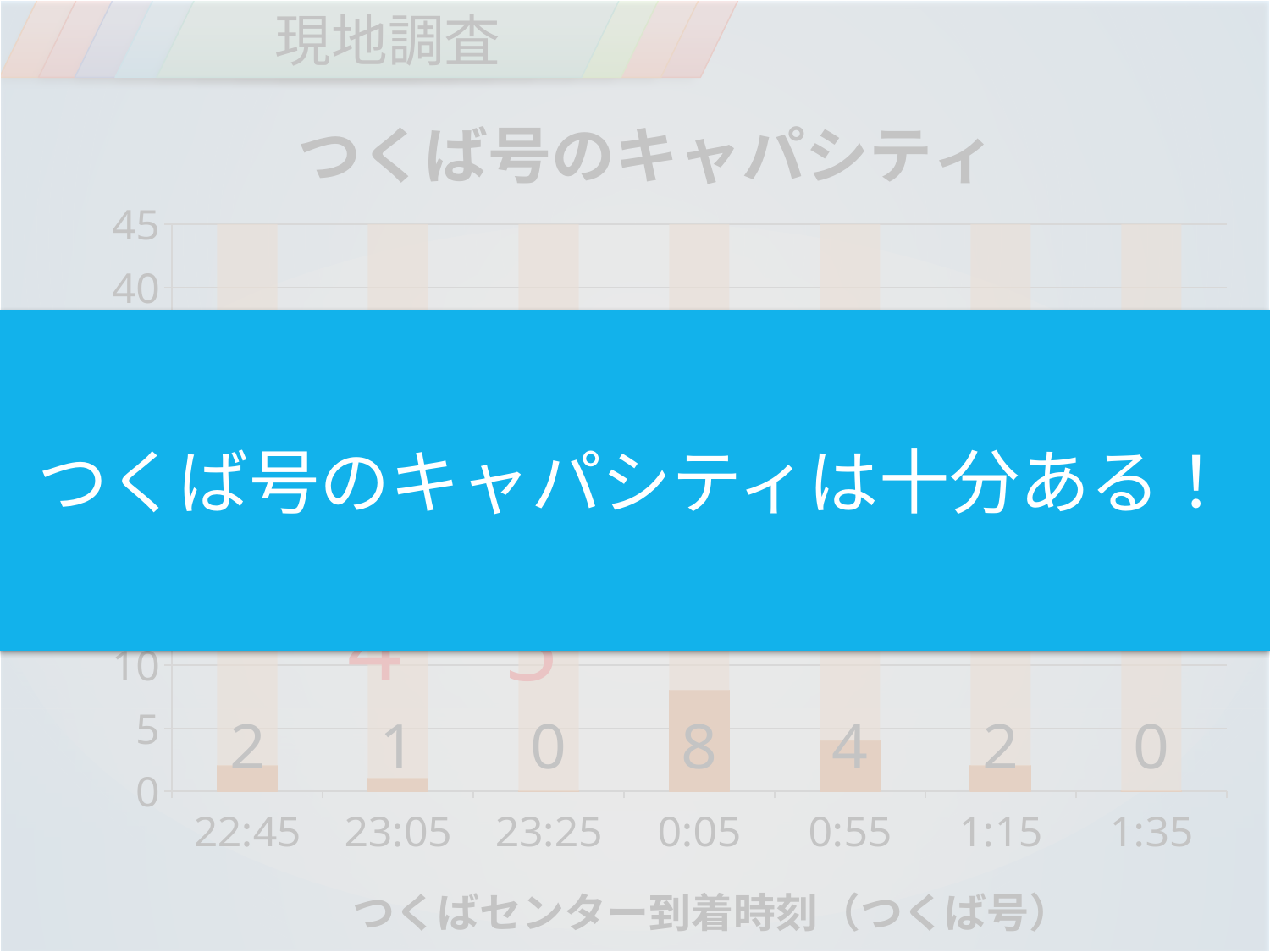
What is the title of the chart? つくば号のキャパシティ What is the value shown for 0:05 in the lower data labels? 8 How many arrival time categories are shown on the x axis? 7 Is the lower data label value for 0:05 greater or less than 5? greater What kind of chart is shown on the slide? bar chart Which arrival time has the highest value among the lower data labels? 0:05 What is the value shown for 22:45 in the lower data labels? 2 What is the value shown for 23:05 in the lower data labels? 1 What is the difference between the lower data label values for 0:05 and 0:55? 4 Which has a larger lower data label value, 22:45 or 0:05? 0:05 What is the value shown for 0:55 in the lower data labels? 4 What is the x-axis title of the chart? つくばセンター到着時刻（つくば号）